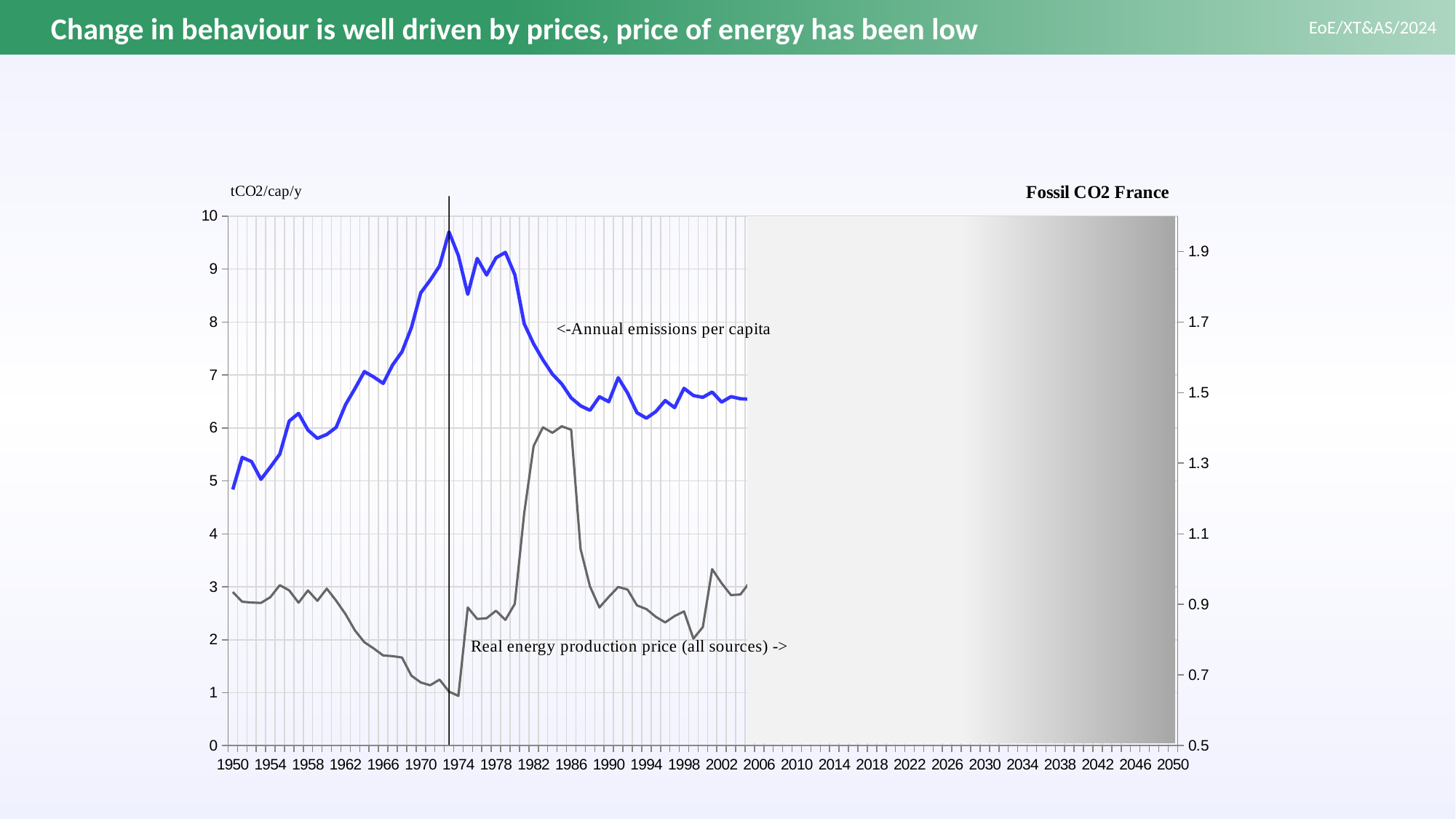
How many data series are plotted on the chart? 2 What is the title of the chart? Fossil CO2 France Is the Annual emissions per capita value in 2004 greater or less than 6 tCO2/cap/y? greater Is the Real energy production price value at its 1984 peak greater or less than 1.3 on the right axis? greater Is the Real energy production price value in 1974 greater or less than 0.7 on the right axis? less In which year does the Annual emissions per capita series reach its highest value? 1973 Does the Annual emissions per capita series rise or fall between 1950 and 1973? rise Does the Annual emissions per capita series rise or fall between 1979 and 1990? fall What kind of chart is shown on the slide? line chart What unit is shown on the left vertical axis? tCO2/cap/y